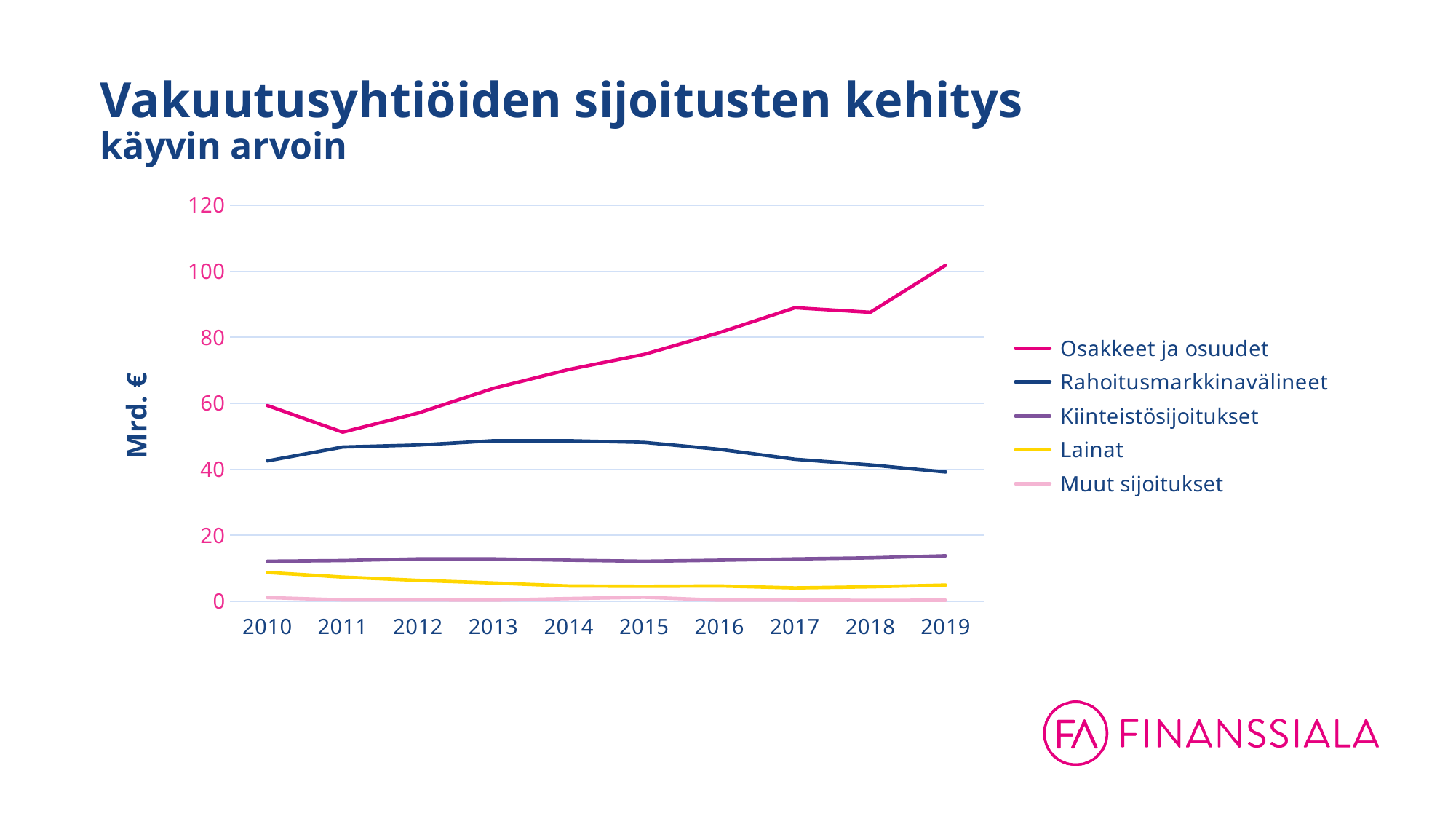
How many years are shown on the x axis? 10 Which series has the highest value in 2019? Osakkeet ja osuudet Is the value for Osakkeet ja osuudet in 2011 greater or less than 60? less Is the value for Osakkeet ja osuudet in 2019 greater or less than 100? greater What unit is shown on the y axis label? Mrd. € Which is larger in 2019: Kiinteistösijoitukset or Lainat? Kiinteistösijoitukset Does the Osakkeet ja osuudet series rise or fall from 2011 to 2019? rise How many series does the legend list? 5 Which series has the lowest value in 2019? Muut sijoitukset Which is larger in 2010: Osakkeet ja osuudet or Rahoitusmarkkinavälineet? Osakkeet ja osuudet What kind of chart is shown on the slide? line chart